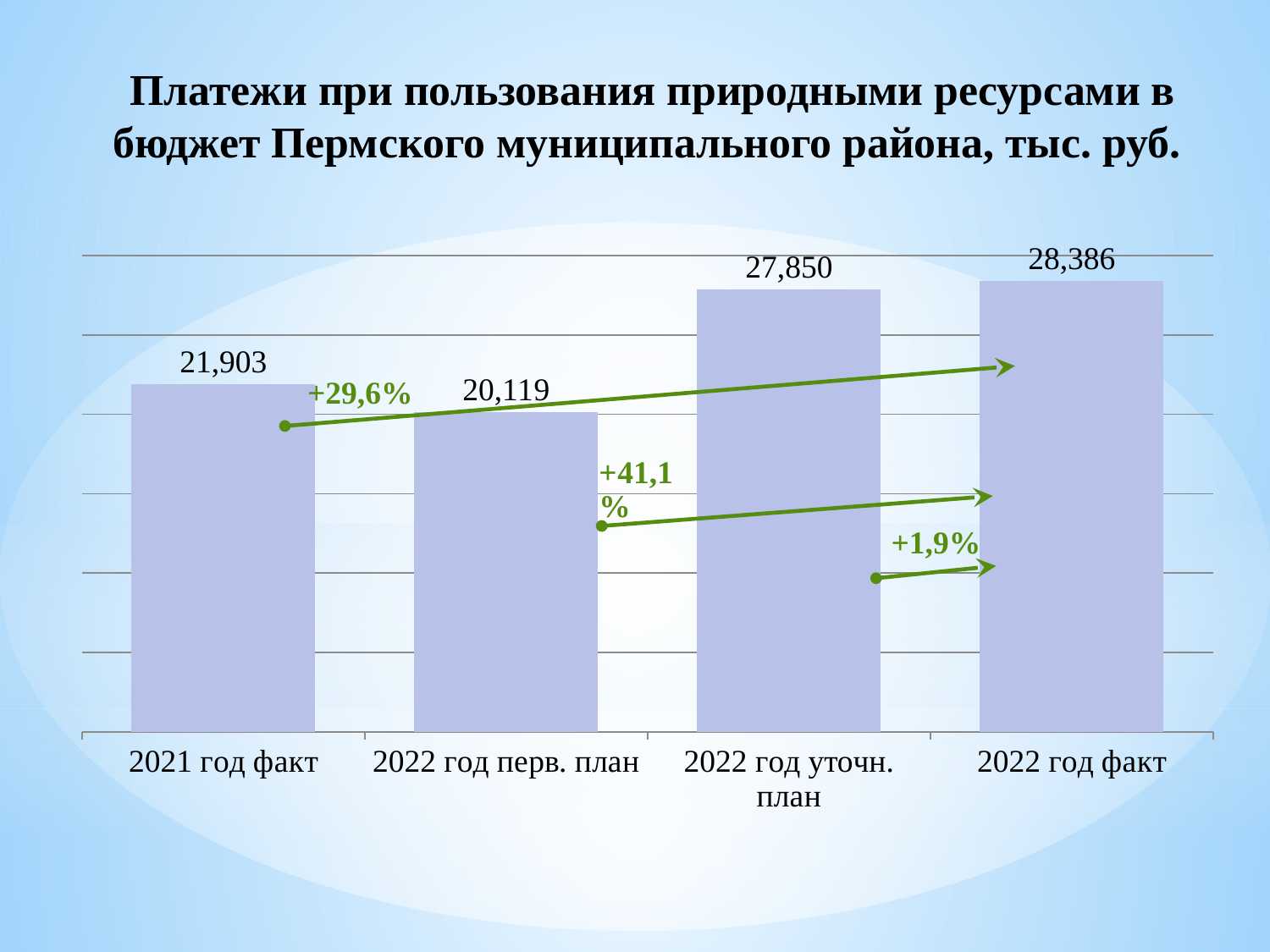
What is the value for 2022 год перв. план? 20,119 What percentage change is annotated between 2022 год уточн. план and 2022 год факт? +1,9% What is the difference between the values for 2022 год уточн. план and 2022 год перв. план? 7,731 What is the value for 2022 год факт? 28,386 What is the value for 2021 год факт? 21,903 Which category has the lowest value? 2022 год перв. план What is the difference between the values for 2022 год факт and 2021 год факт? 6,483 What kind of chart is shown on the slide? Bar chart How many categories are shown on the x axis? 4 Which is larger, the value for 2021 год факт or the value for 2022 год перв. план? 2021 год факт Which category has the highest value? 2022 год факт What is the value for 2022 год уточн. план? 27,850